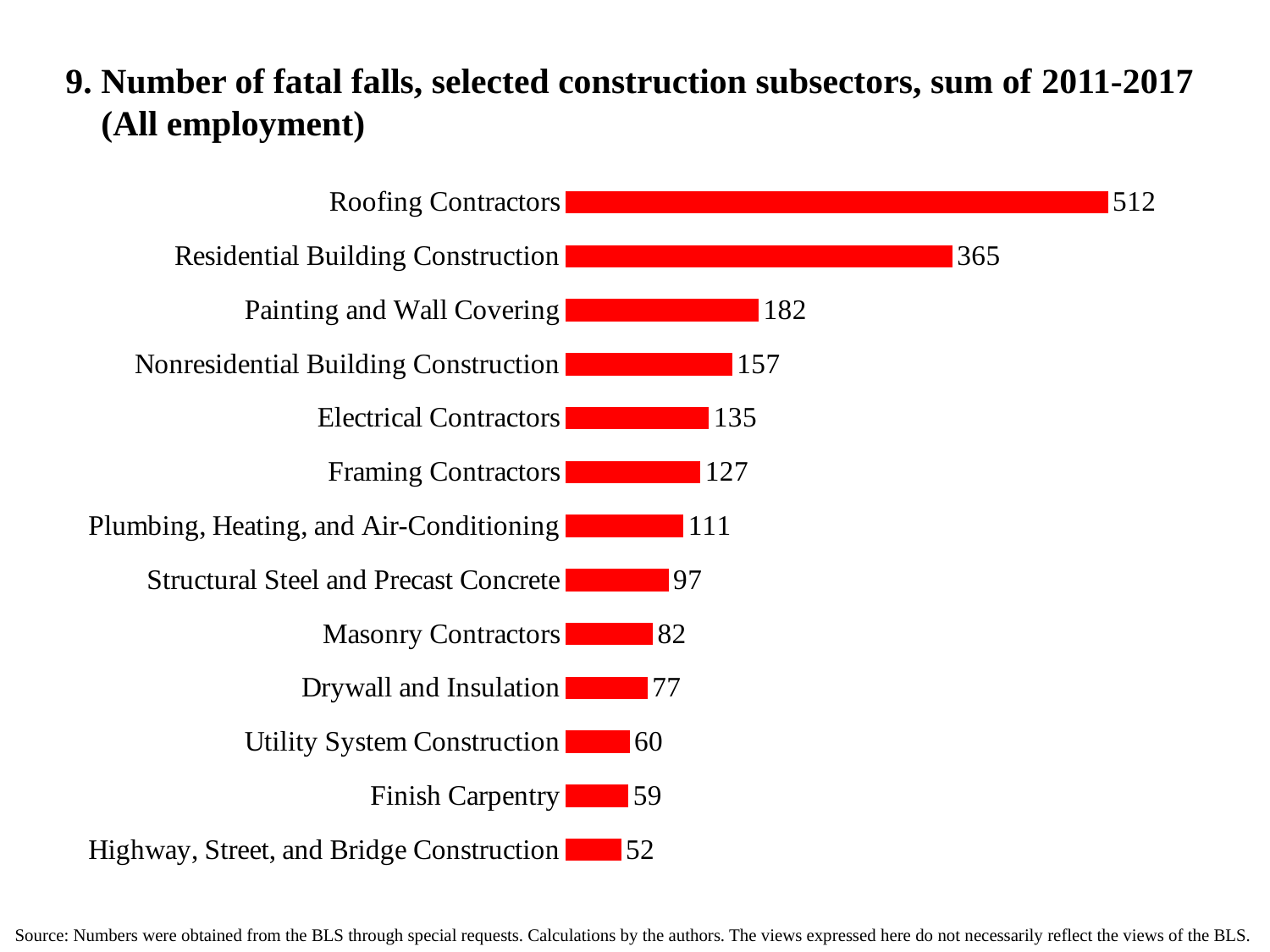
What is the number of fatal falls for Electrical Contractors? 135 What kind of chart is shown on the slide? Bar chart Which has more fatal falls, Framing Contractors or Plumbing, Heating, and Air-Conditioning? Framing Contractors What is the number of fatal falls for Roofing Contractors? 512 Which subsector has the lowest number of fatal falls? Highway, Street, and Bridge Construction What is the number of fatal falls for Drywall and Insulation? 77 What colour are the bars in the chart? Red What is the difference in fatal falls between Painting and Wall Covering and Nonresidential Building Construction? 25 Which subsector has the highest number of fatal falls? Roofing Contractors What is the difference in fatal falls between Roofing Contractors and Residential Building Construction? 147 How many construction subsectors are shown in the chart? 13 Which has more fatal falls, Masonry Contractors or Structural Steel and Precast Concrete? Structural Steel and Precast Concrete